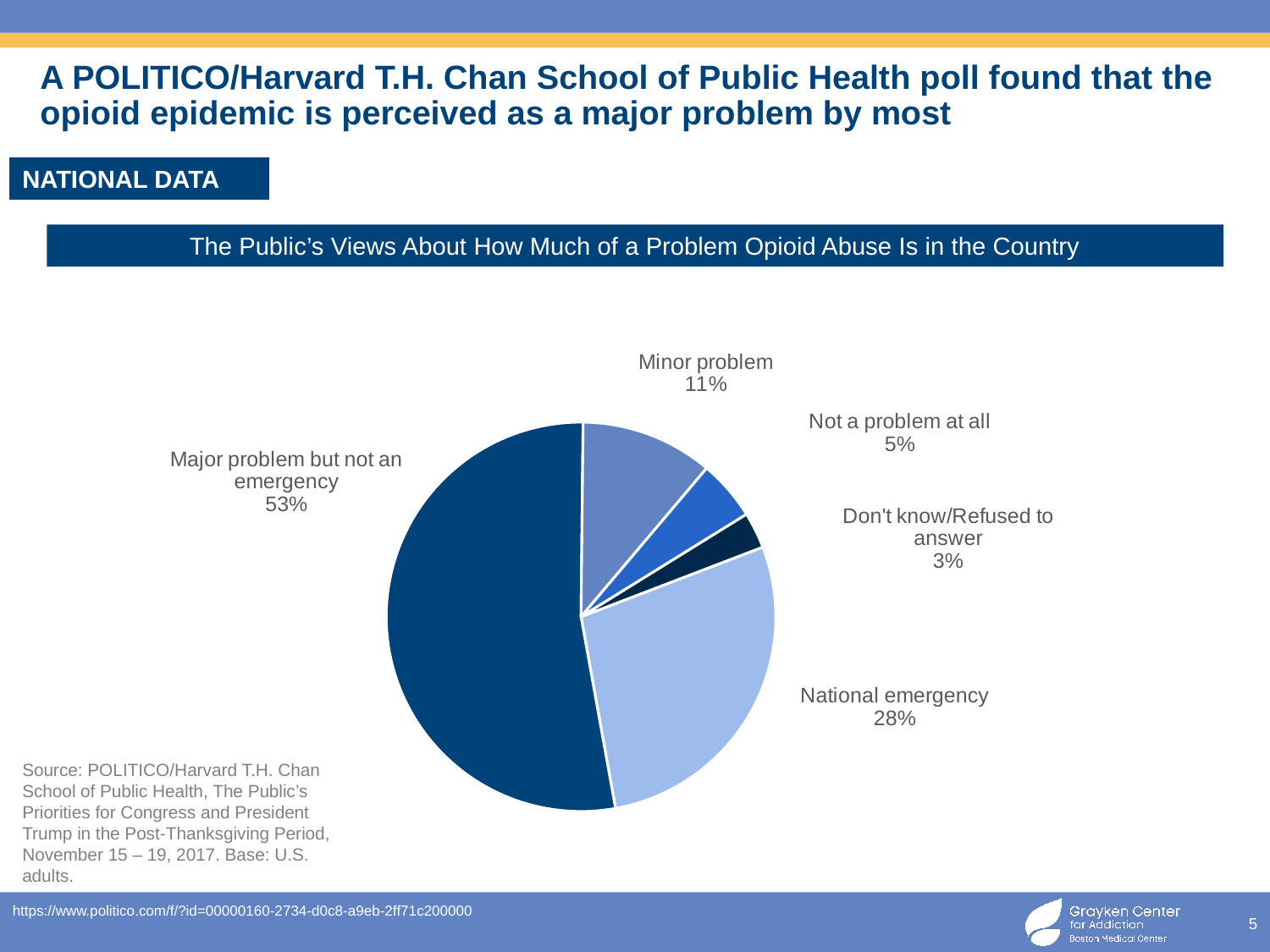
Which response has the largest share of the pie? Major problem but not an emergency What percentage of respondents said opioid abuse is a major problem but not an emergency? 53% What is the difference in percentage points between 'Major problem but not an emergency' and 'National emergency'? 25 Which is larger: the share for 'Minor problem' or the share for 'Not a problem at all'? Minor problem What is the title of the chart? The Public's Views About How Much of a Problem Opioid Abuse Is in the Country What percentage of respondents said opioid abuse is a minor problem? 11% What percentage of respondents said opioid abuse is not a problem at all? 5% What percentage of respondents said opioid abuse is a national emergency? 28% How many slices does the pie chart have? 5 Which response has the smallest share of the pie? Don't know/Refused to answer What kind of chart is shown on the slide? pie chart What percentage of respondents answered Don't know/Refused to answer? 3%